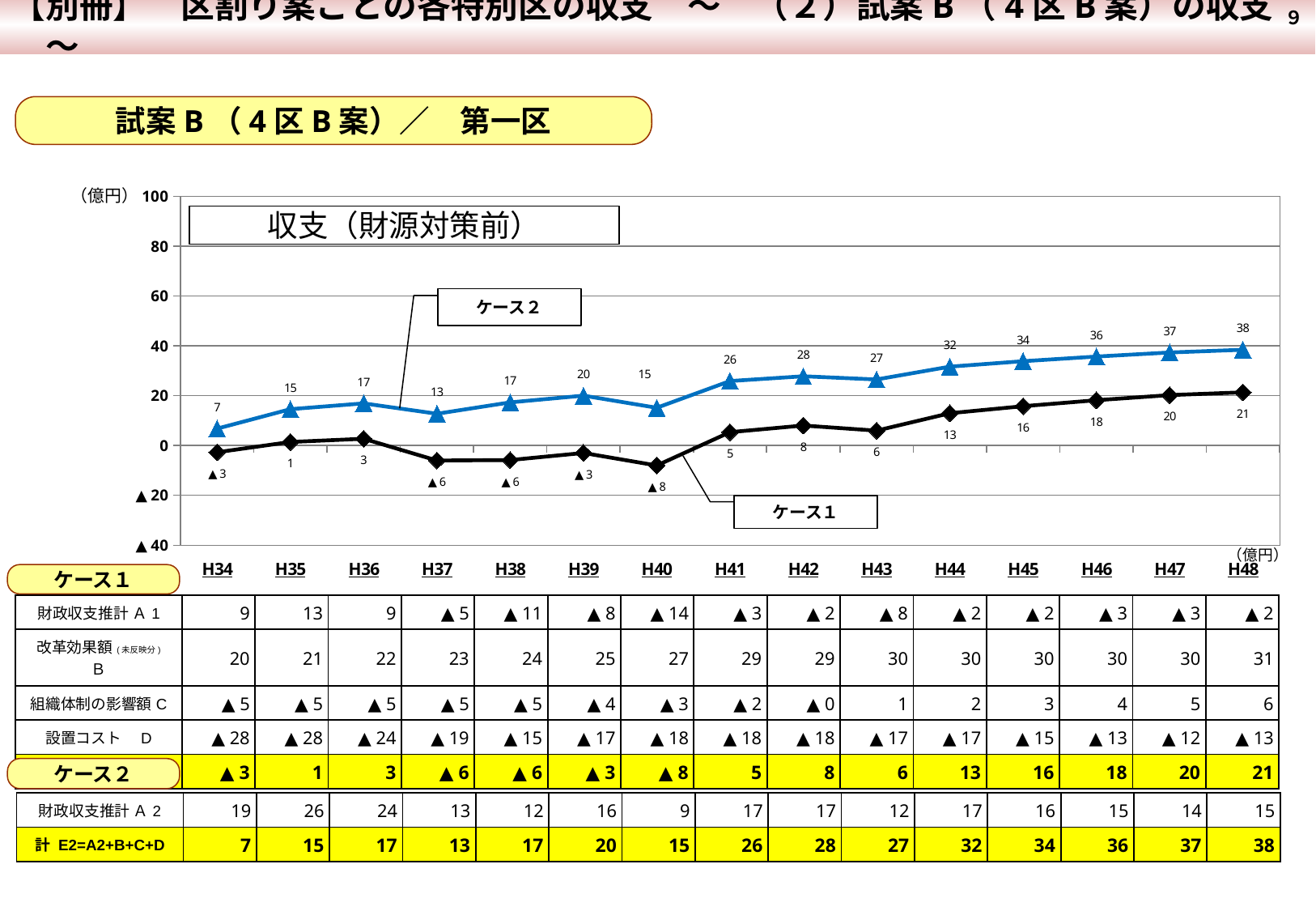
What is the value for ケース2 at H34? 7 What is the value for ケース1 at H40? ▲8 How many years are plotted on the x axis? 15 At which year is ケース1 at its lowest value? H40 At which year does ケース2 reach its highest value? H48 Which is larger at H42, ケース1 or ケース2? ケース2 What is the title shown inside the chart? 収支（財源対策前） What is the value for ケース2 at H48? 38 Is the value for ケース2 at H44 greater or less than 20? greater How many series are plotted in the chart? 2 What is the difference between ケース2 and ケース1 at H48? 17 What kind of chart is shown? line chart